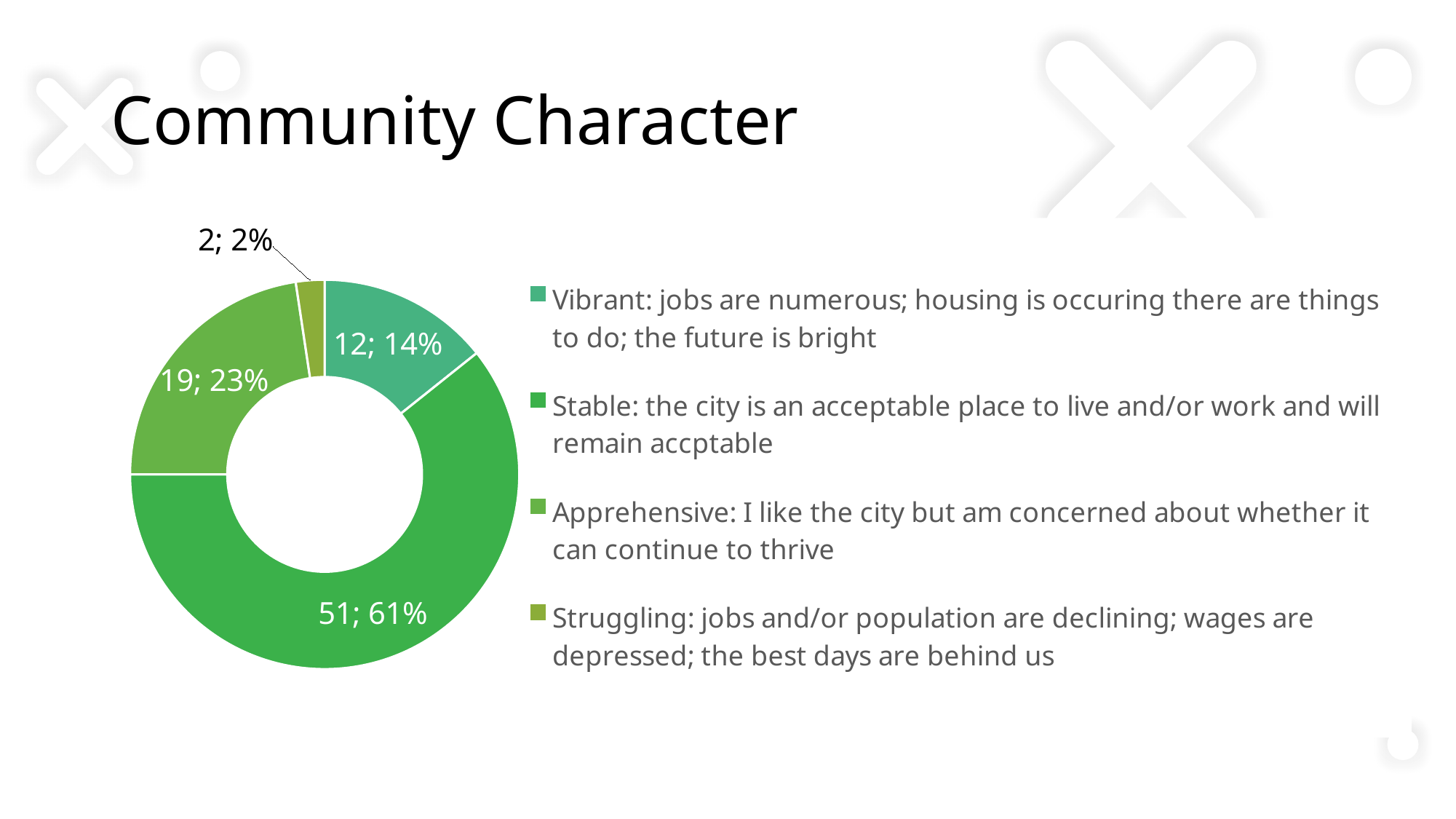
Which category has the largest slice? Stable What count and percentage are shown for the Apprehensive slice? 19; 23% What is the difference in count between the Stable and Apprehensive slices? 32 What type of chart is shown on the slide? Doughnut chart How many slices does the doughnut chart have? 4 What count and percentage are shown for the Stable slice? 51; 61% Which is larger, the Vibrant slice or the Apprehensive slice? Apprehensive Which category has the smallest slice? Struggling What count and percentage are shown for the Struggling slice? 2; 2% What share of the doughnut does the Apprehensive slice represent? 23% How many entries does the legend list? 4 What count and percentage are shown for the Vibrant slice? 12; 14%